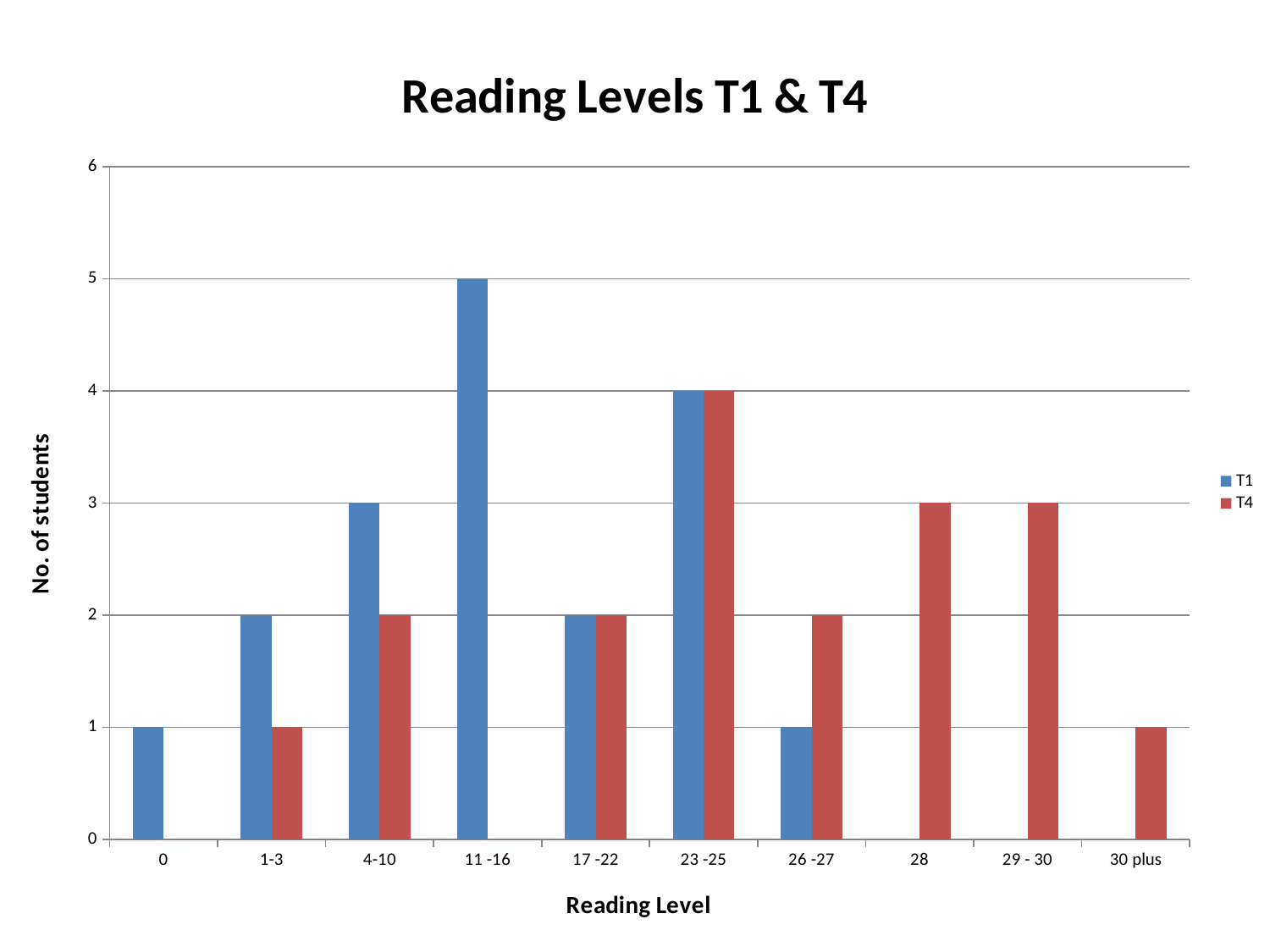
What is the number of students for T1 at reading level 11 -16? 5 At reading level 4-10, which series has more students, T1 or T4? T1 What colour are the T4 bars? red Which reading level has the highest number of students for T1? 11 -16 What is the number of students for T4 at reading level 28? 3 What is the difference between T1 and T4 at reading level 26 -27? 1 What is the title of the chart? Reading Levels T1 & T4 What is the number of students for T1 at reading level 4-10? 3 How many series does the legend list? 2 Which reading level has the highest number of students for T4? 23 -25 How many reading level categories are shown on the x axis? 10 What type of chart is shown on the slide? bar chart